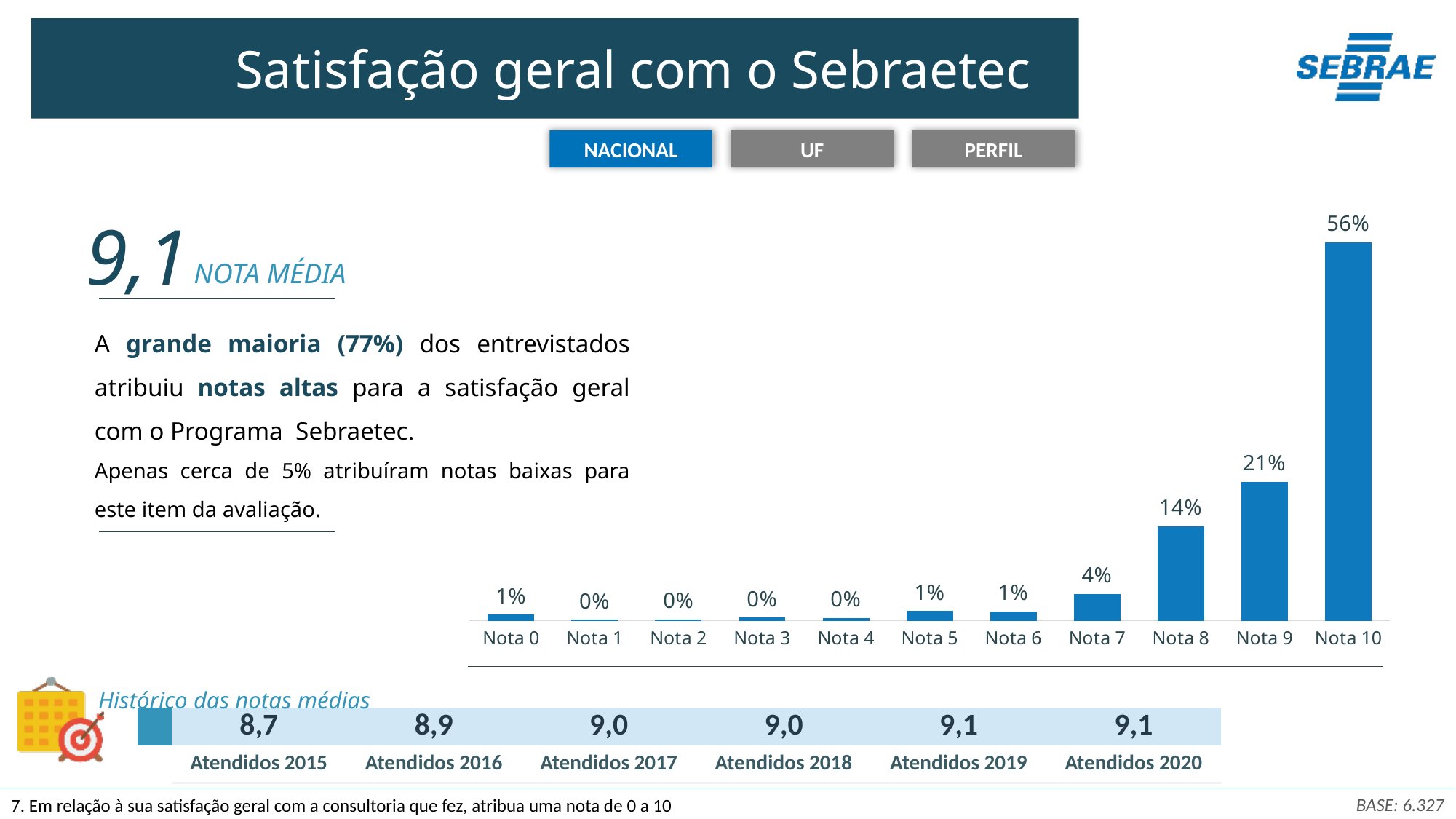
What is the difference between the values for Nota 9 and Nota 8? 7% What is the value shown for Nota 7? 4% What kind of chart is shown on the slide? Bar chart What percentage of respondents gave Nota 10? 56% Which category has the highest value in the chart? Nota 10 Do the values generally rise or fall from Nota 7 to Nota 10? Rise Which is larger, the value for Nota 8 or the value for Nota 7? Nota 8 What is the value shown for Nota 8? 14% What is the value shown for Nota 9? 21% What is the difference between the values for Nota 10 and Nota 9? 35% What is the combined value of Nota 8, Nota 9 and Nota 10? 91% How many categories (notas) are shown on the x axis of the chart? 11